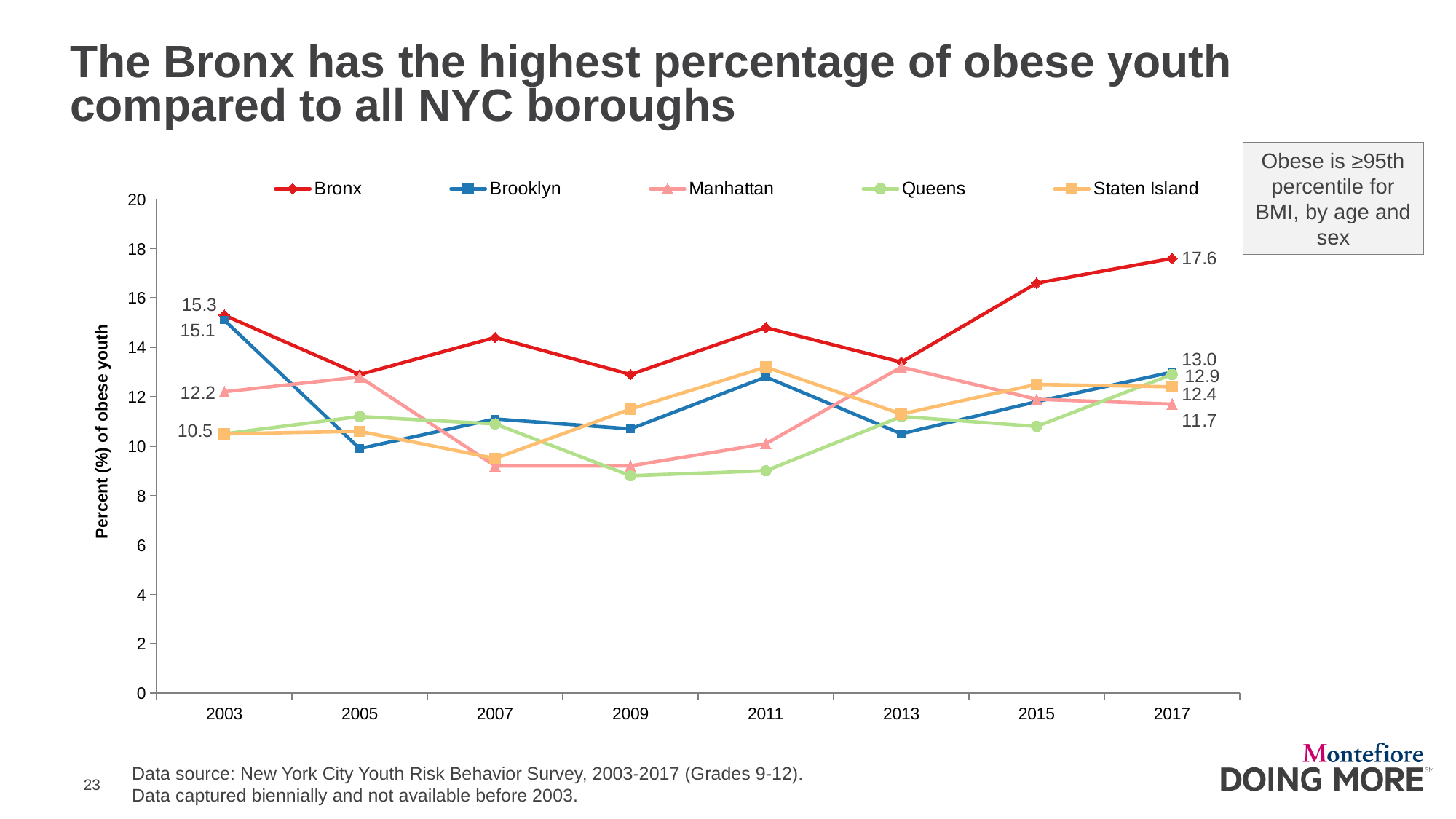
Which borough has the highest value in 2017? Bronx How many series does the legend list? 5 By how much did the Bronx value increase from 2003 to 2017? 2.3 Which borough has the lowest value in 2017? Manhattan How many years are plotted along the x axis? 8 Is the value for the Bronx in 2015 greater or less than 16? greater What is the value for the Bronx in 2017? 17.6 What kind of chart is shown on the slide? Line chart What is the value for the Bronx in 2003? 15.3 What is the value for Brooklyn in 2003? 15.1 Which is larger in 2017, the value for Brooklyn or the value for Staten Island? Brooklyn What is the value for Manhattan in 2017? 11.7